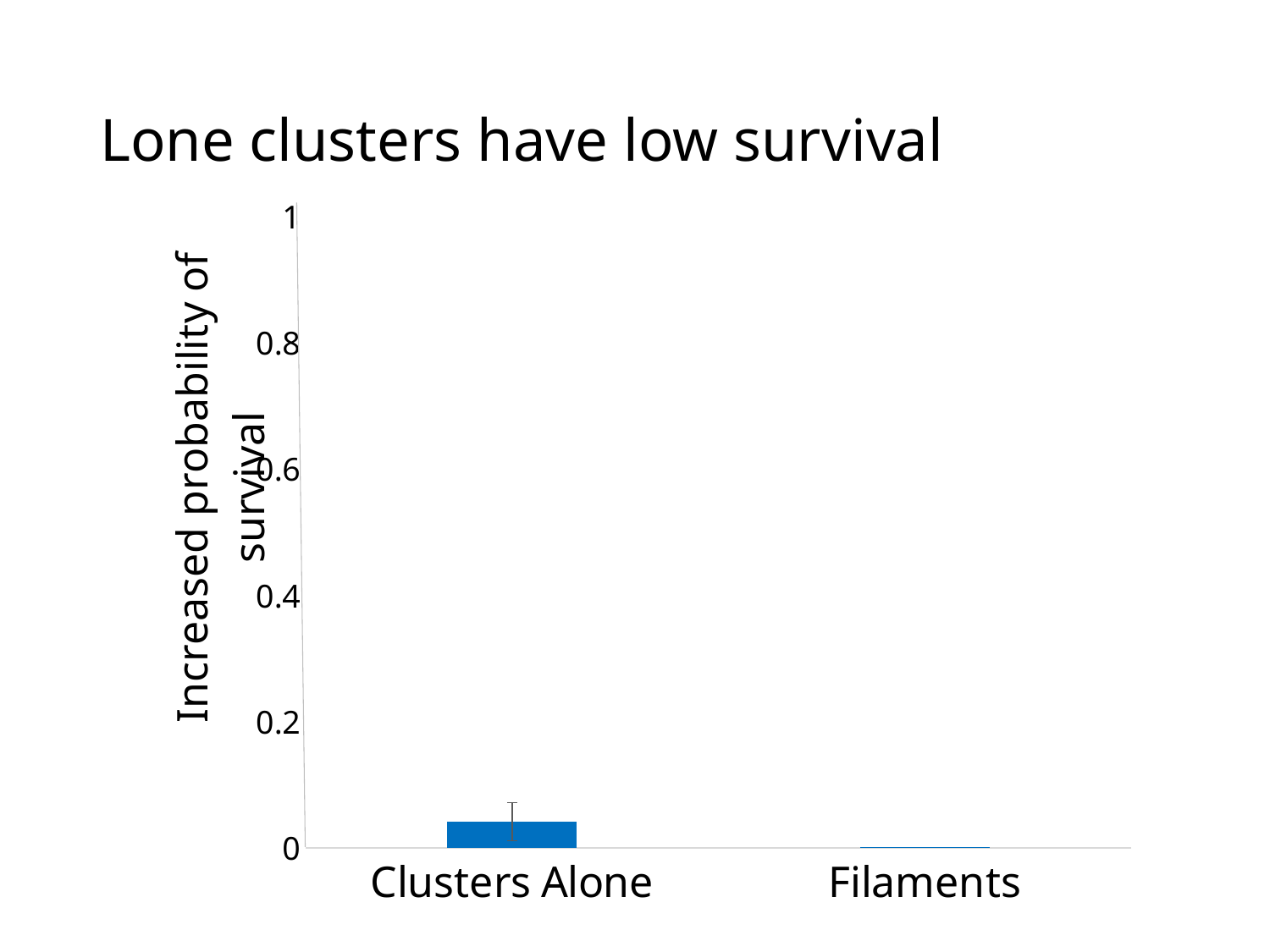
Which category has the higher value in the chart? Clusters Alone Which is larger, the value for Clusters Alone or the value for Filaments? Clusters Alone What kind of chart is shown on the slide? bar chart Is the value for Clusters Alone greater or less than 0.2? less What is the label on the y axis of the chart? Increased probability of survival Is the value for Filaments greater or less than 0.2? less Is the value for Clusters Alone greater or less than 0.4? less What is the title of the slide containing the chart? Lone clusters have low survival Which category has the lower value in the chart? Filaments What is the highest tick value shown on the y axis? 1 How many categories are shown on the x axis of the chart? 2